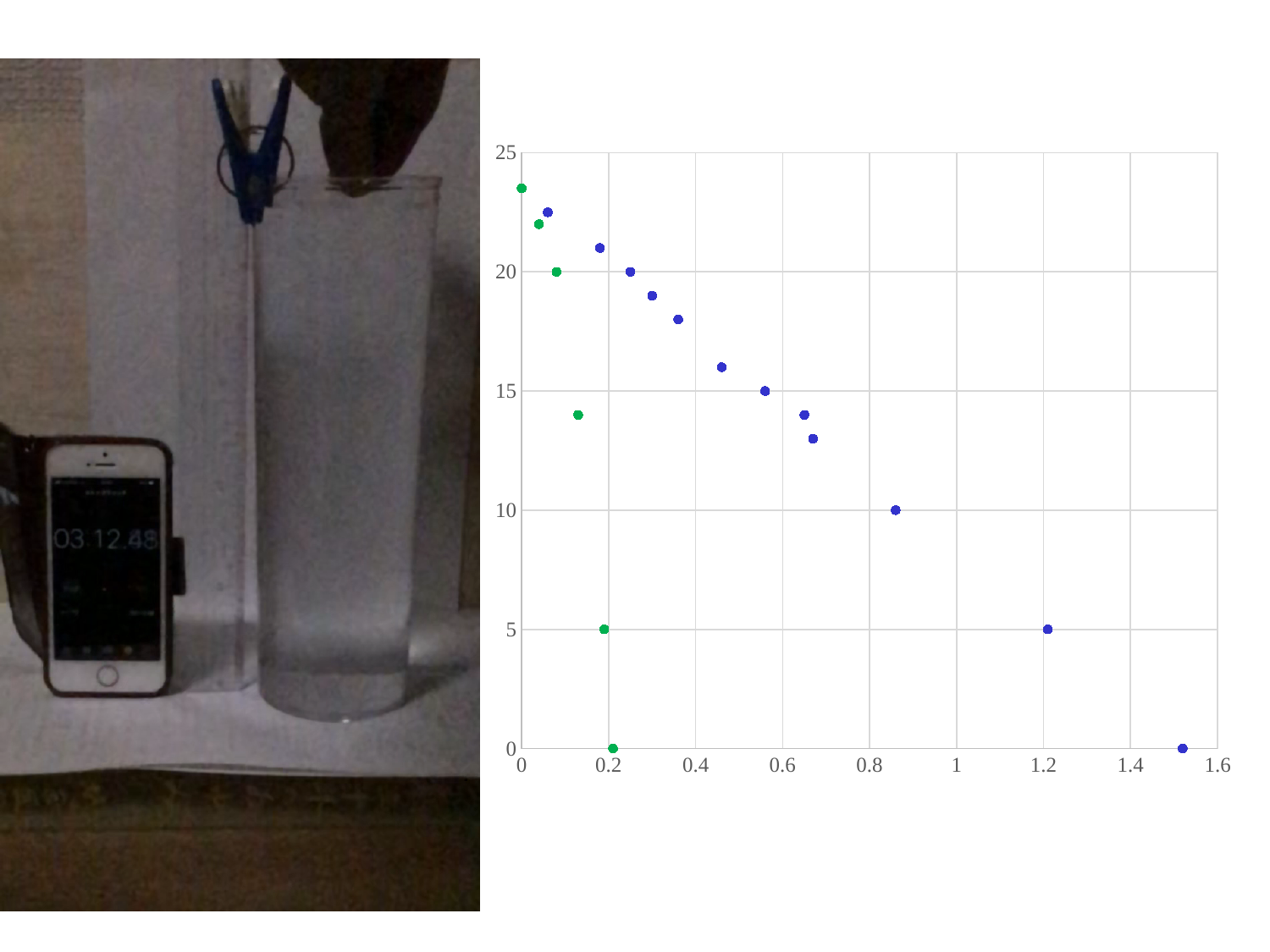
How many blue points are plotted on the chart? 12 How many green points are plotted on the chart? 6 What is the y value of the blue point at about x = 1.2? 5 Is the y value of the green point at about x = 0.13 greater or less than 20? less Do the y values of the blue points rise or fall as x increases? fall How many different colours of points are plotted on the chart? 2 Which colour of points reaches a y value of 0 at the smaller x value, blue or green? green Is the y value of the blue point at about x = 0.36 greater or less than 15? greater What kind of chart is shown on the slide? scatter chart What is the y value of the rightmost blue point (at about x = 1.5)? 0 Which colour of points has the highest y value on the chart, blue or green? green Do the y values of the green points rise or fall as x increases? fall